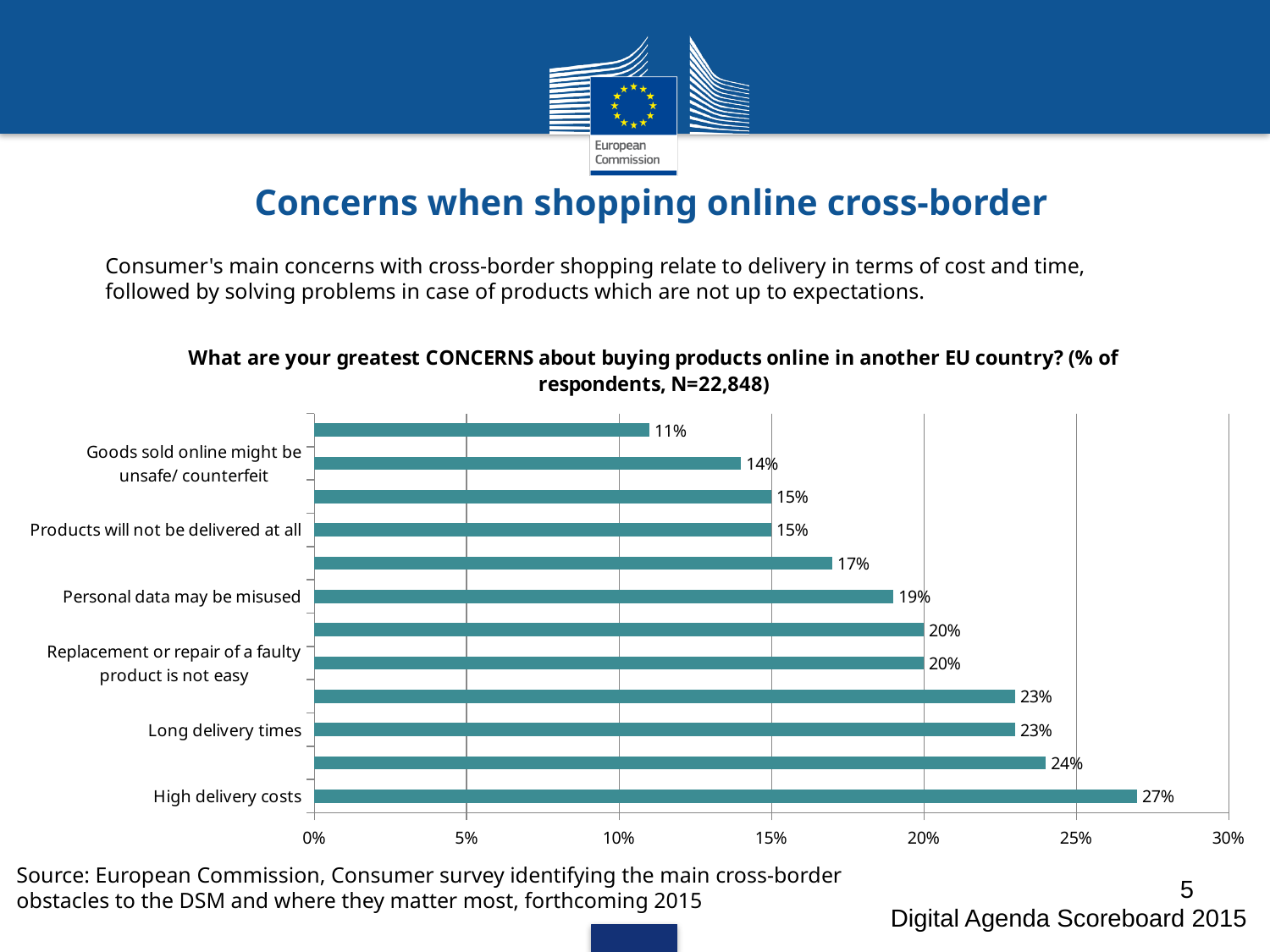
What is the value for 'Long delivery times'? 23% What percentage of respondents were concerned that products will not be delivered at all? 15% Which is larger: the value for 'Personal data may be misused' or the value for 'Products will not be delivered at all'? Personal data may be misused What is the smallest value shown on the chart? 11% What is the difference between the values for 'High delivery costs' and 'Long delivery times'? 4 percentage points Which concern has the highest percentage of respondents? High delivery costs What is the value for 'Goods sold online might be unsafe/ counterfeit'? 14% What kind of chart is shown on the slide? Bar chart How many bars are plotted on the chart? 12 What is the value for 'Personal data may be misused'? 19% What percentage of respondents said replacement or repair of a faulty product is not easy? 20% What percentage of respondents cited high delivery costs as a concern? 27%